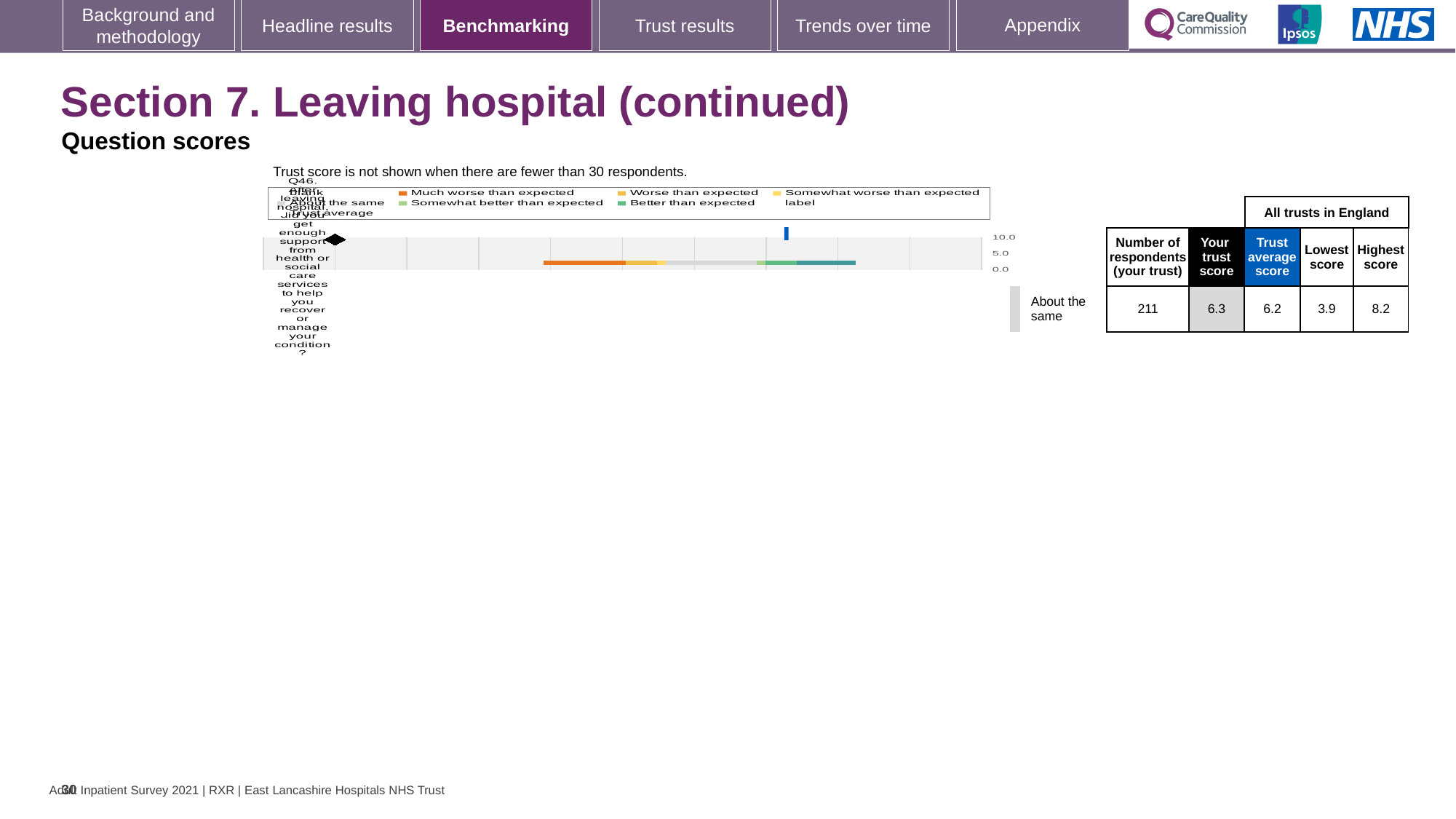
Which is larger for Q46: Your trust score or the Trust average score? Your trust score What kind of chart is used to show the Q46 benchmarking result? Bar chart What is the difference between Your trust score and the Trust average score for Q46? 0.1 How many respondents from the trust answered Q46? 211 How many questions are plotted on the chart? 1 What benchmark category is the trust's Q46 result placed in, as labelled to the right of the chart? About the same What is the difference between the Highest score and the Lowest score for Q46? 4.3 What is the Trust average score for Q46 shown in the table next to the chart? 6.2 What is the Highest score across all trusts in England for Q46? 8.2 What is the trust score (Your trust score) for Q46 shown in the table next to the chart? 6.3 What is the Lowest score across all trusts in England for Q46? 3.9 What is the highest value shown on the chart's score axis? 10.0